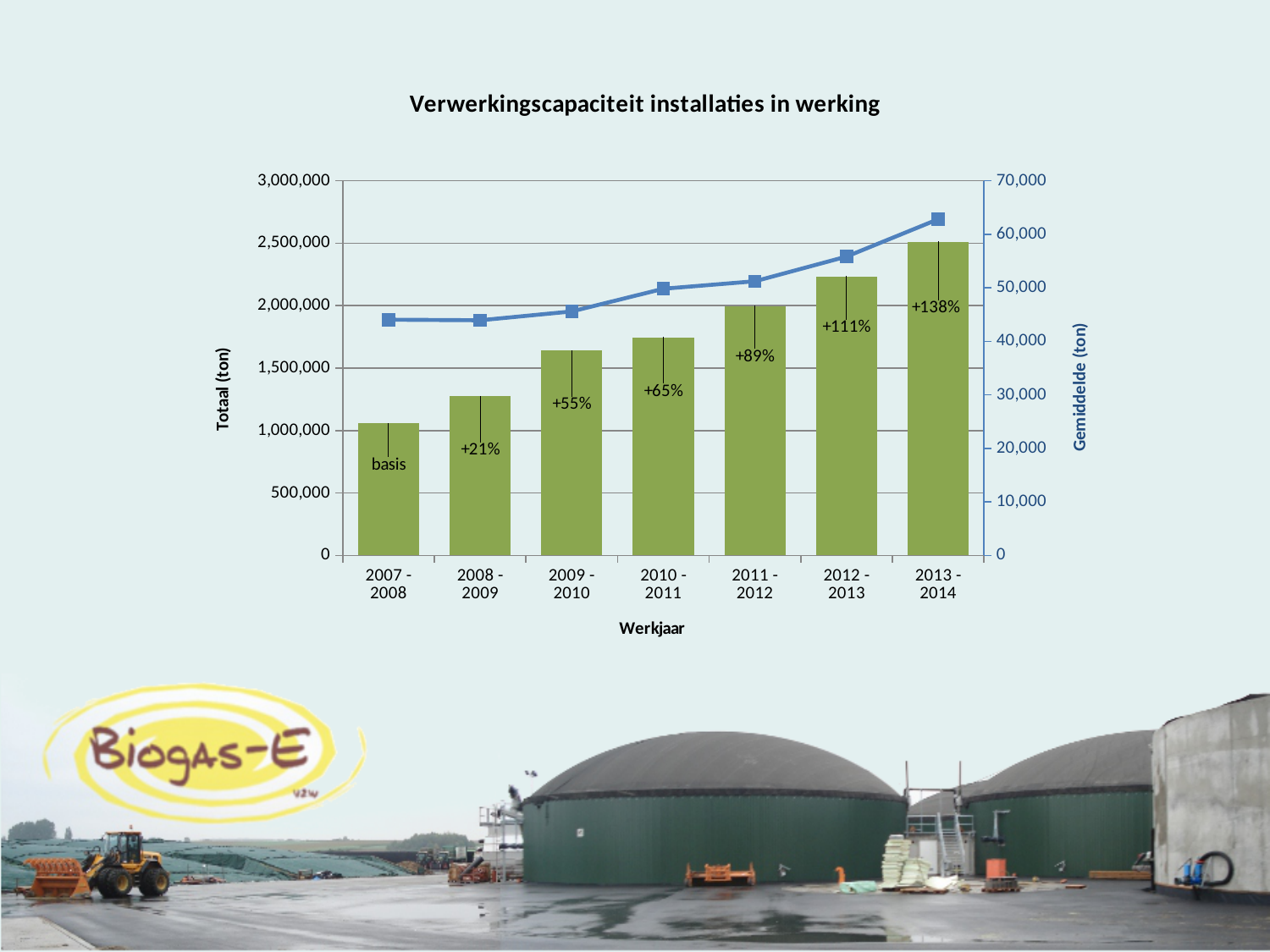
What label is shown on the bar for 2007 - 2008? basis Is the bar value for 2012 - 2013 greater or less than 2,000,000? greater Do the bar values rise or fall from 2007 - 2008 to 2013 - 2014? rise What label is shown on the bar for 2013 - 2014? +138% What label is shown on the bar for 2011 - 2012? +89% Which werkjaar has the highest bar? 2013 - 2014 What label is shown on the bar for 2009 - 2010? +55% Which werkjaar has the lowest bar? 2007 - 2008 Is the bar value for 2008 - 2009 greater or less than 1,500,000? less Which bar is taller, 2010 - 2011 or 2012 - 2013? 2012 - 2013 What is the title of the chart? Verwerkingscapaciteit installaties in werking How many werkjaar categories are shown on the x axis? 7